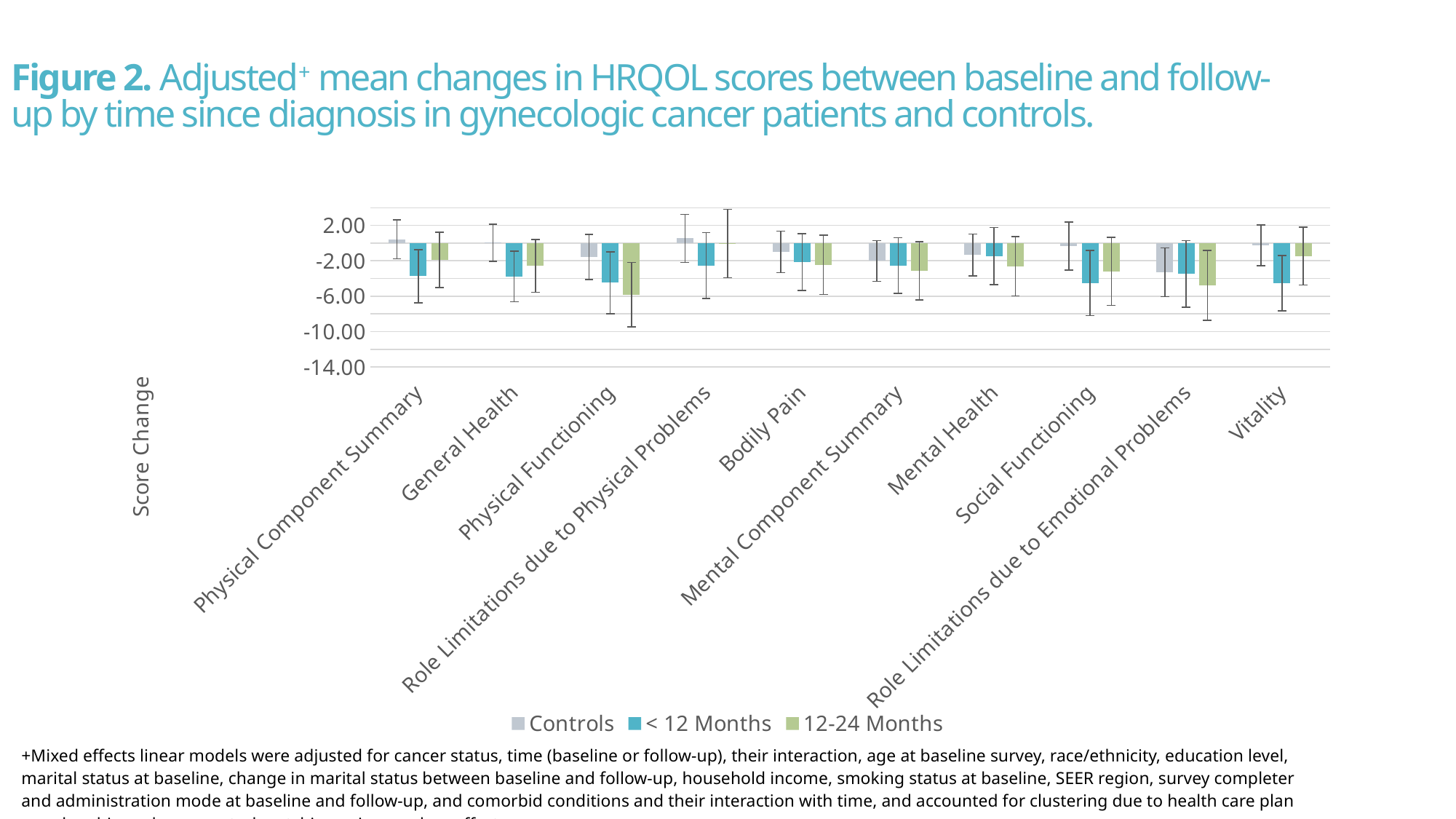
What is the label on the vertical axis? Score Change For which category does the 12-24 Months series show its most negative score change? Physical Functioning How many series does the legend list? 3 Is the value for 12-24 Months in Physical Functioning greater or less than -2.00? less Is the value for Controls in Role Limitations due to Physical Problems greater or less than -2.00? greater In Social Functioning, which series shows the larger decrease (bar extending further below zero): < 12 Months or 12-24 Months? < 12 Months What are the three series named in the legend? Controls, < 12 Months, 12-24 Months Is the value for 12-24 Months in Role Limitations due to Emotional Problems greater or less than -2.00? less How many HRQOL domains (categories) are shown along the x axis? 10 What kind of chart is shown on the slide? bar chart